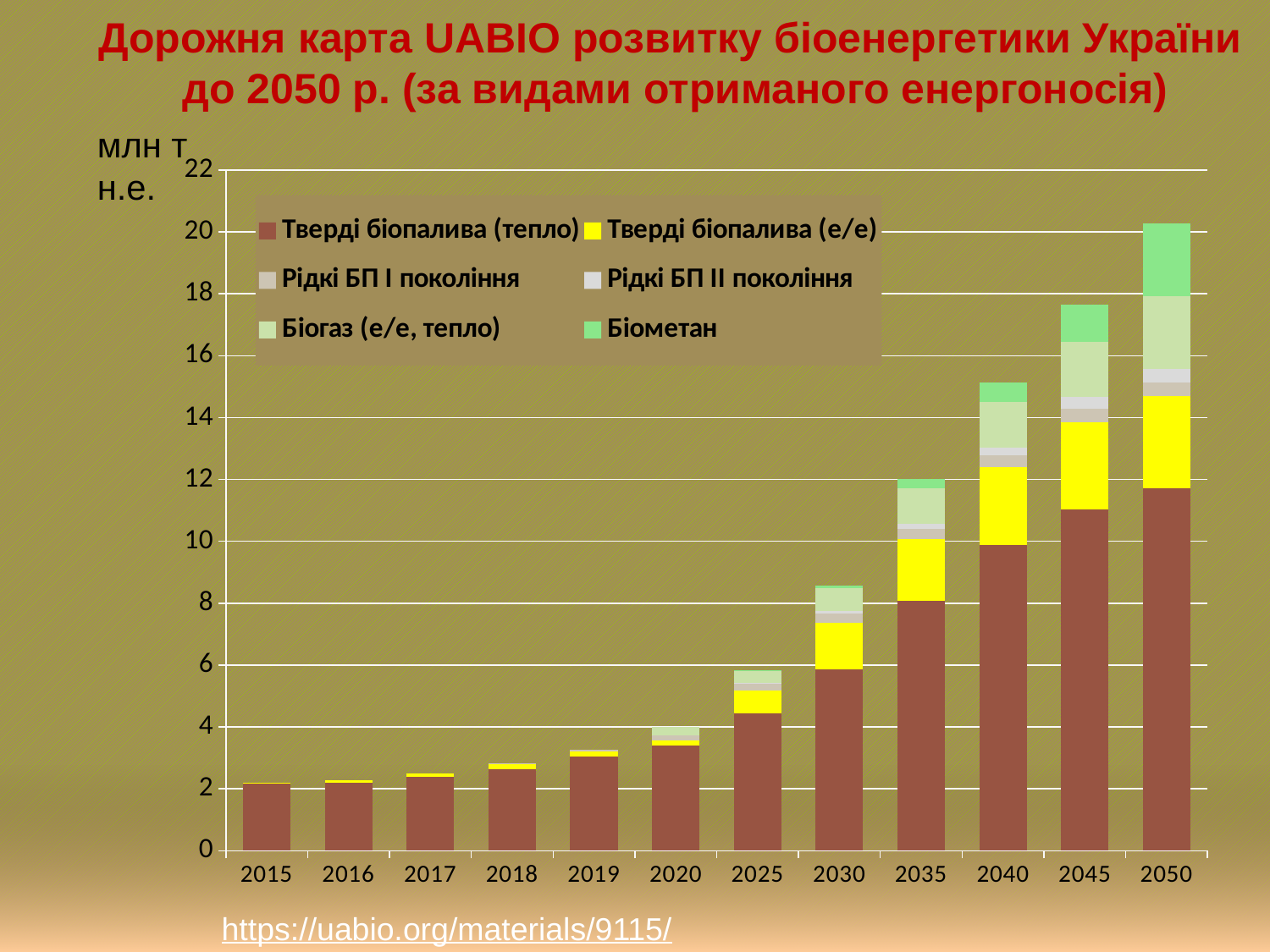
What unit is shown on the y axis of the chart? млн т н.е. Which year has the shortest stacked bar? 2015 Is the total bar height for 2040 greater or less than 14? greater How many series does the legend list? 6 Which year has the tallest stacked bar? 2050 Is the total bar height for 2030 greater or less than 8? greater Do the total bar heights rise or fall from 2015 to 2050? Rise Which year has a taller stacked bar, 2030 or 2040? 2040 Is the total bar height for 2025 greater or less than 4? greater What kind of chart is shown on the slide? Stacked bar chart How many years are shown along the x axis? 12